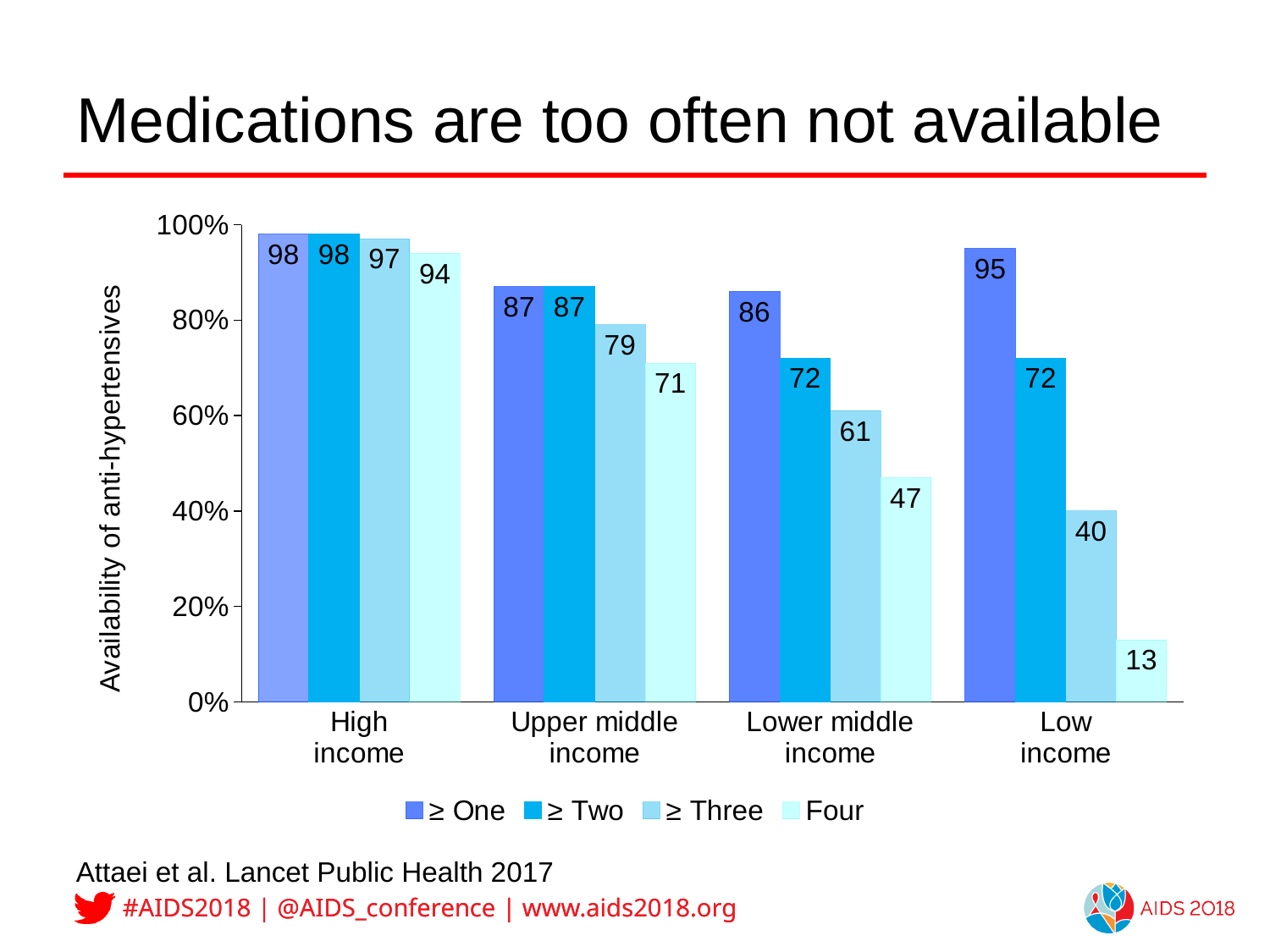
Which is larger: the ≥ Two value for Upper middle income or the ≥ Two value for Low income? Upper middle income How many income categories are shown on the x axis? 4 What is the difference between the Four values for High income and Lower middle income? 47 What is the difference between the ≥ One and Four values in the Low income category? 82 How many series does the legend list? 4 What is the value for Four in the Low income category? 13 What is the value for ≥ One in the Upper middle income category? 87 What kind of chart is shown on the slide? Bar chart What is the value for ≥ Three in the Lower middle income category? 61 Which income category has the lowest value for Four? Low income Which income category has the highest value for ≥ One? High income What is the label of the y axis? Availability of anti-hypertensives